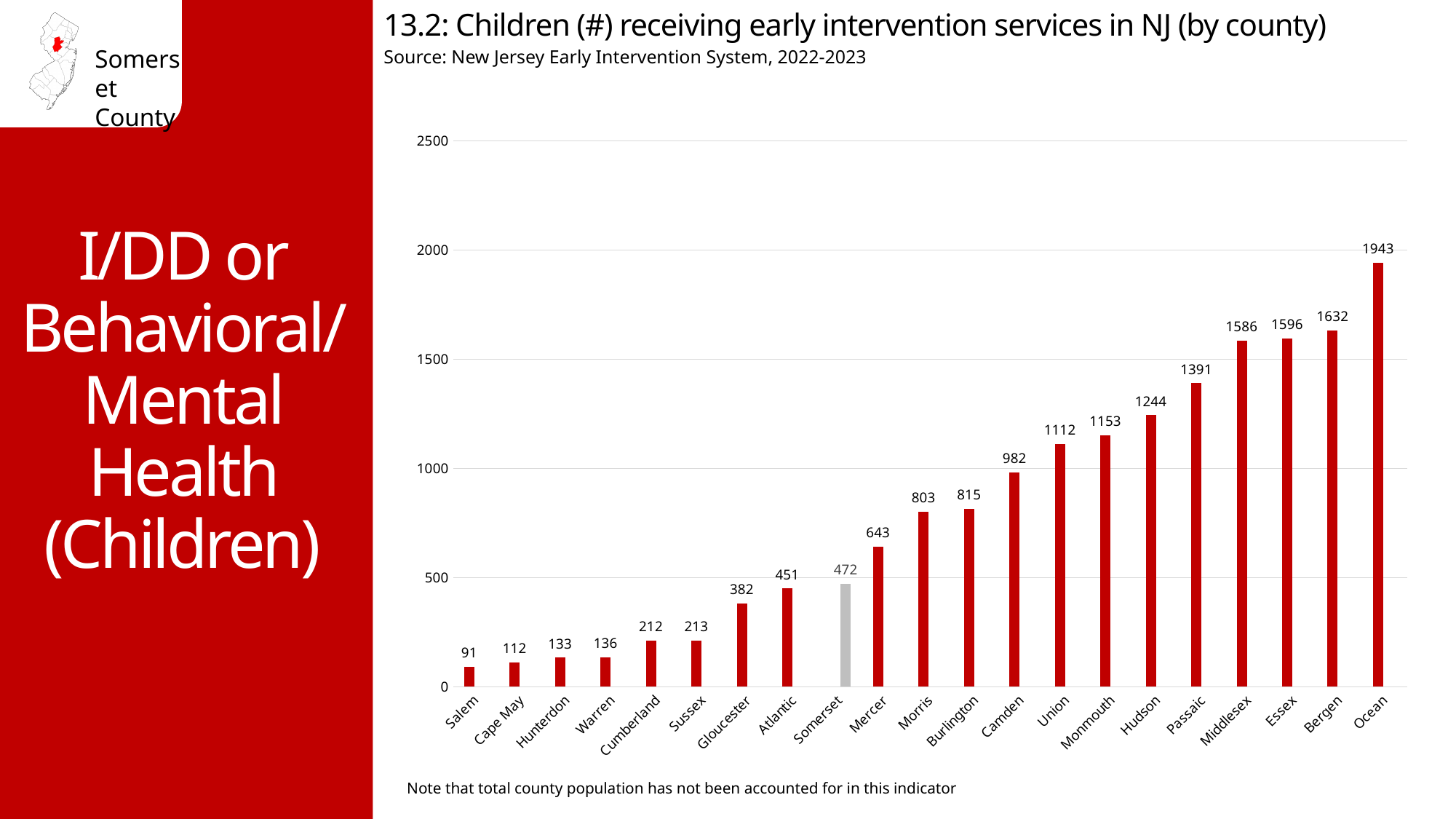
What is the difference between the values for Ocean and Bergen? 311 Which county has a larger value, Camden or Union? Union Which county has the highest number of children receiving early intervention services? Ocean What is the difference between the values for Mercer and Somerset? 171 What kind of chart is shown on the slide? Bar chart What is the value shown for Hudson County? 1244 How many counties are shown on the x axis? 21 Which county's bar is coloured grey instead of red? Somerset Is the value for Passaic greater or less than 1500? less How many children are receiving early intervention services in Somerset County? 472 Do the values rise or fall moving from left to right along the x axis? Rise Which county has the lowest number of children receiving early intervention services? Salem